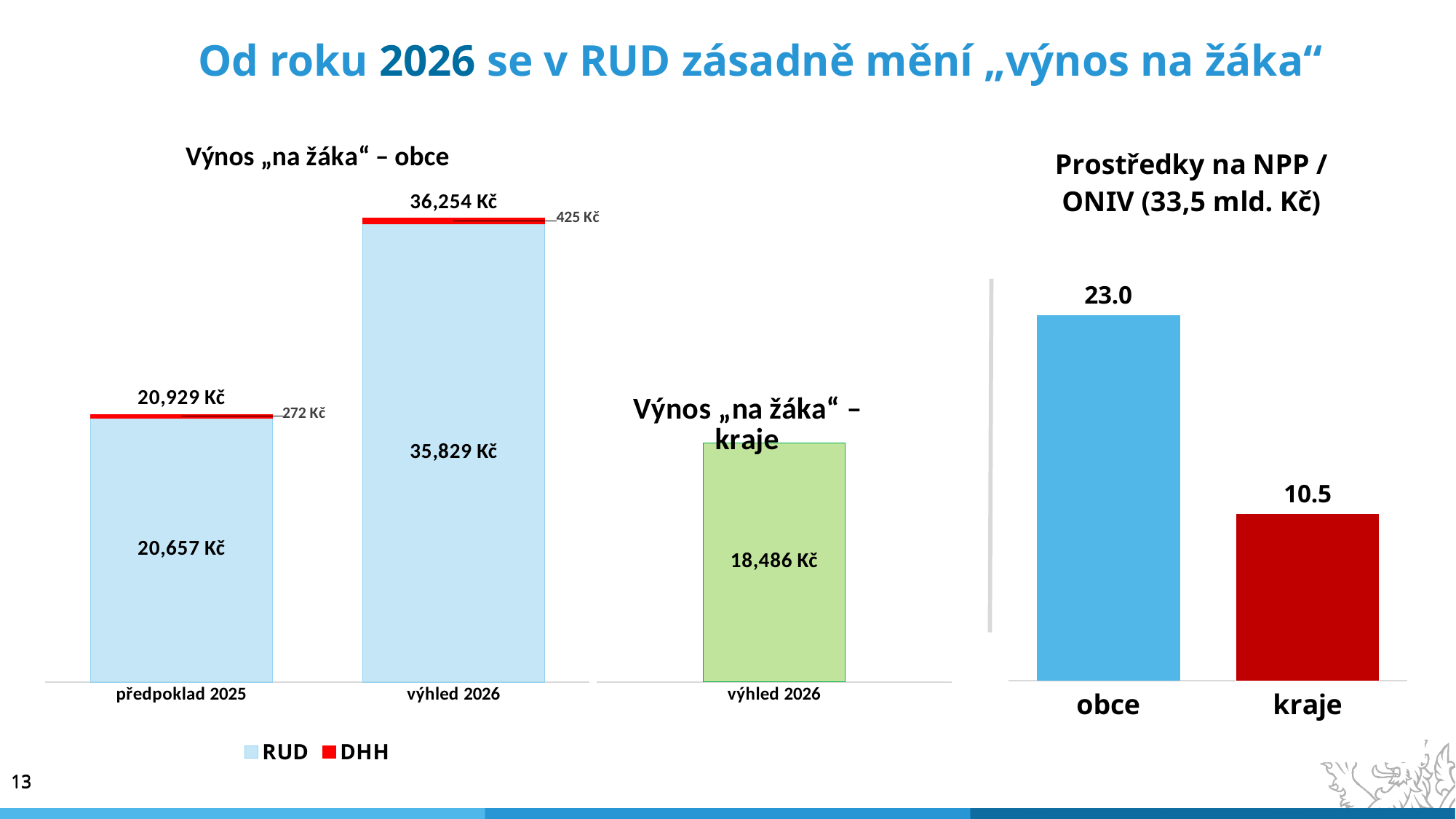
In the chart "Výnos „na žáka“ – obce", what is the total of the stacked bar for předpoklad 2025? 20,929 Kč In the chart "Výnos „na žáka“ – obce", what is the difference between the RUD values for výhled 2026 and předpoklad 2025? 15,172 Kč In the chart "Výnos „na žáka“ – obce", what is the total of the stacked bar for výhled 2026? 36,254 Kč In the chart "Výnos „na žáka“ – kraje", what is the value for výhled 2026? 18,486 Kč What kind of chart is "Prostředky na NPP / ONIV (33,5 mld. Kč)"? bar chart In the chart "Prostředky na NPP / ONIV (33,5 mld. Kč)", what is the value for kraje? 10.5 In the chart "Výnos „na žáka“ – obce", which category has the higher total, předpoklad 2025 or výhled 2026? výhled 2026 In the chart "Prostředky na NPP / ONIV (33,5 mld. Kč)", what is the difference between the values for obce and kraje? 12.5 In the chart "Výnos „na žáka“ – obce", what is the RUD value for předpoklad 2025? 20,657 Kč In the chart "Prostředky na NPP / ONIV (33,5 mld. Kč)", which category has the highest value? obce In the chart "Výnos „na žáka“ – obce", how many series does the legend list? 2 In the chart "Výnos „na žáka“ – obce", what is the DHH value for výhled 2026? 425 Kč